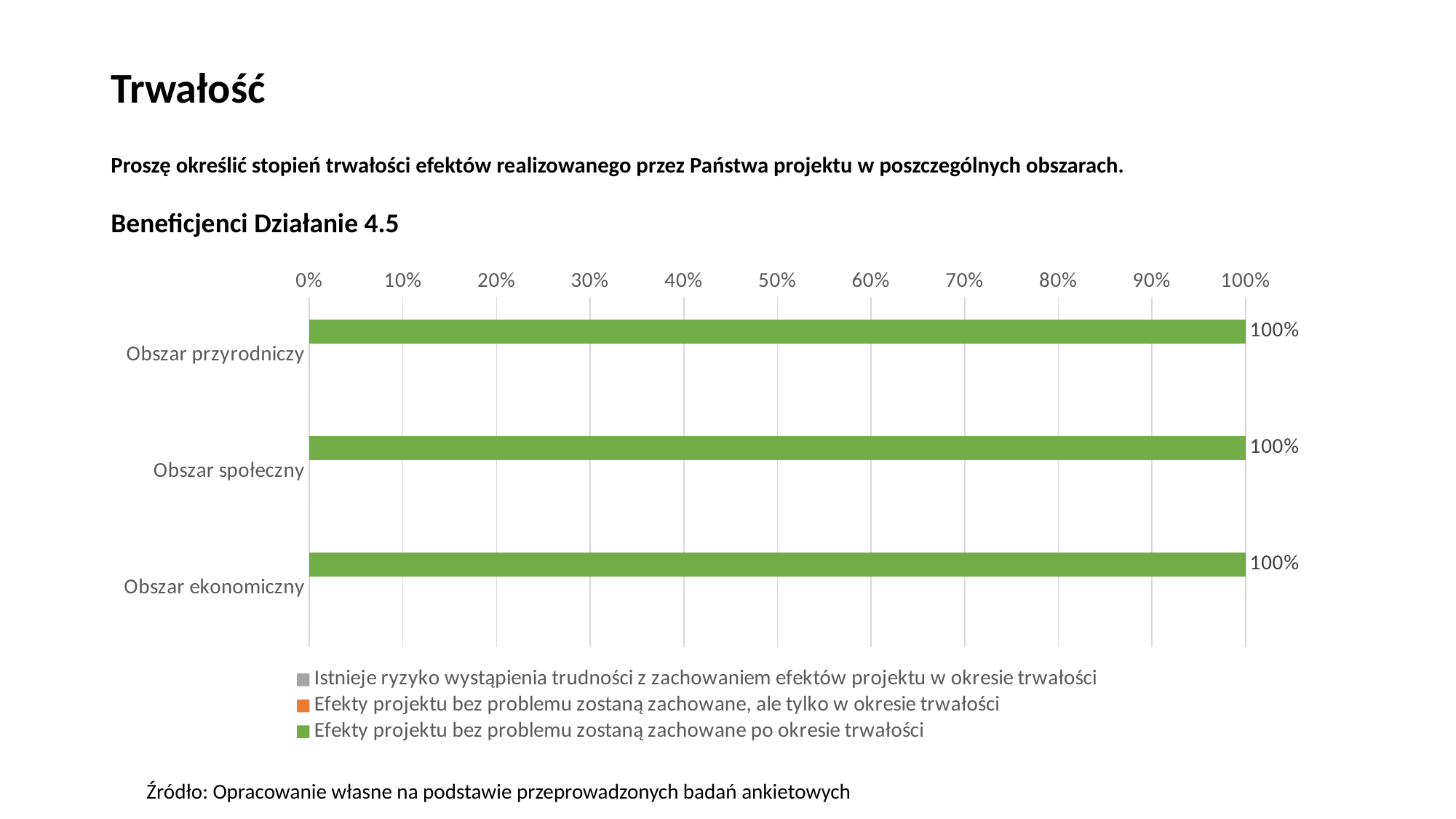
How many categories are shown on the chart? 3 What is the title of the chart? Beneficjenci Działanie 4.5 What kind of chart is shown on the slide? bar chart What is the highest value shown on the horizontal axis? 100% Is the value for Obszar społeczny greater or less than 90%? greater Is the value for Obszar ekonomiczny greater or less than 50%? greater What colour are the bars plotted on the chart? green What is the difference between the values for Obszar przyrodniczy and Obszar ekonomiczny? 0% What is the value for Obszar ekonomiczny for the series 'Efekty projektu bez problemu zostaną zachowane po okresie trwałości'? 100% How many series does the legend list? 3 What is the value for Obszar przyrodniczy for the series 'Efekty projektu bez problemu zostaną zachowane po okresie trwałości'? 100% What is the value for Obszar społeczny for the series 'Efekty projektu bez problemu zostaną zachowane po okresie trwałości'? 100%